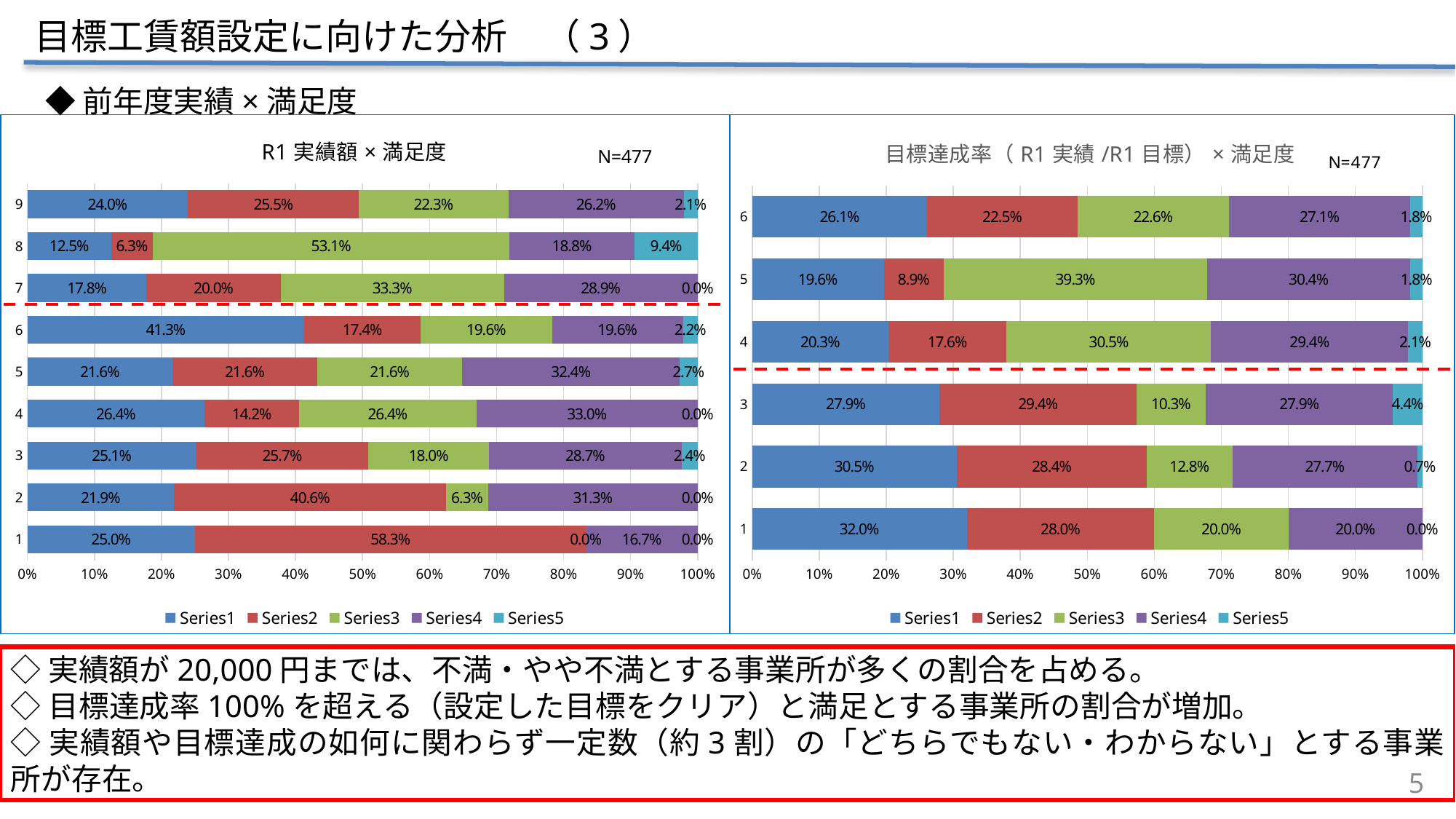
How many categories are plotted in the left chart (R1 実績額 × 満足度)? 9 In the left chart (R1 実績額 × 満足度), what is the Series3 value for category 8? 53.1% How many series does the legend of the right chart (目標達成率 × 満足度) list? 5 In the left chart (R1 実績額 × 満足度), what is the difference between the Series2 values for category 2 and category 8? 34.3% In the left chart (R1 実績額 × 満足度), what is the Series2 value for category 1? 58.3% In the right chart (目標達成率 × 満足度), which category has the lowest Series3 value? 3 What kind of chart is the left chart (R1 実績額 × 満足度)? Stacked bar chart In the left chart (R1 実績額 × 満足度), which category has the highest Series1 value? 6 In the right chart (目標達成率 × 満足度), what is the Series3 value for category 5? 39.3% In the right chart (目標達成率 × 満足度), which is larger: the Series4 value for category 5 or for category 1? Category 5 In the right chart (目標達成率 × 満足度), what is the Series1 value for category 1? 32.0% How many categories are plotted in the right chart (目標達成率 × 満足度)? 6